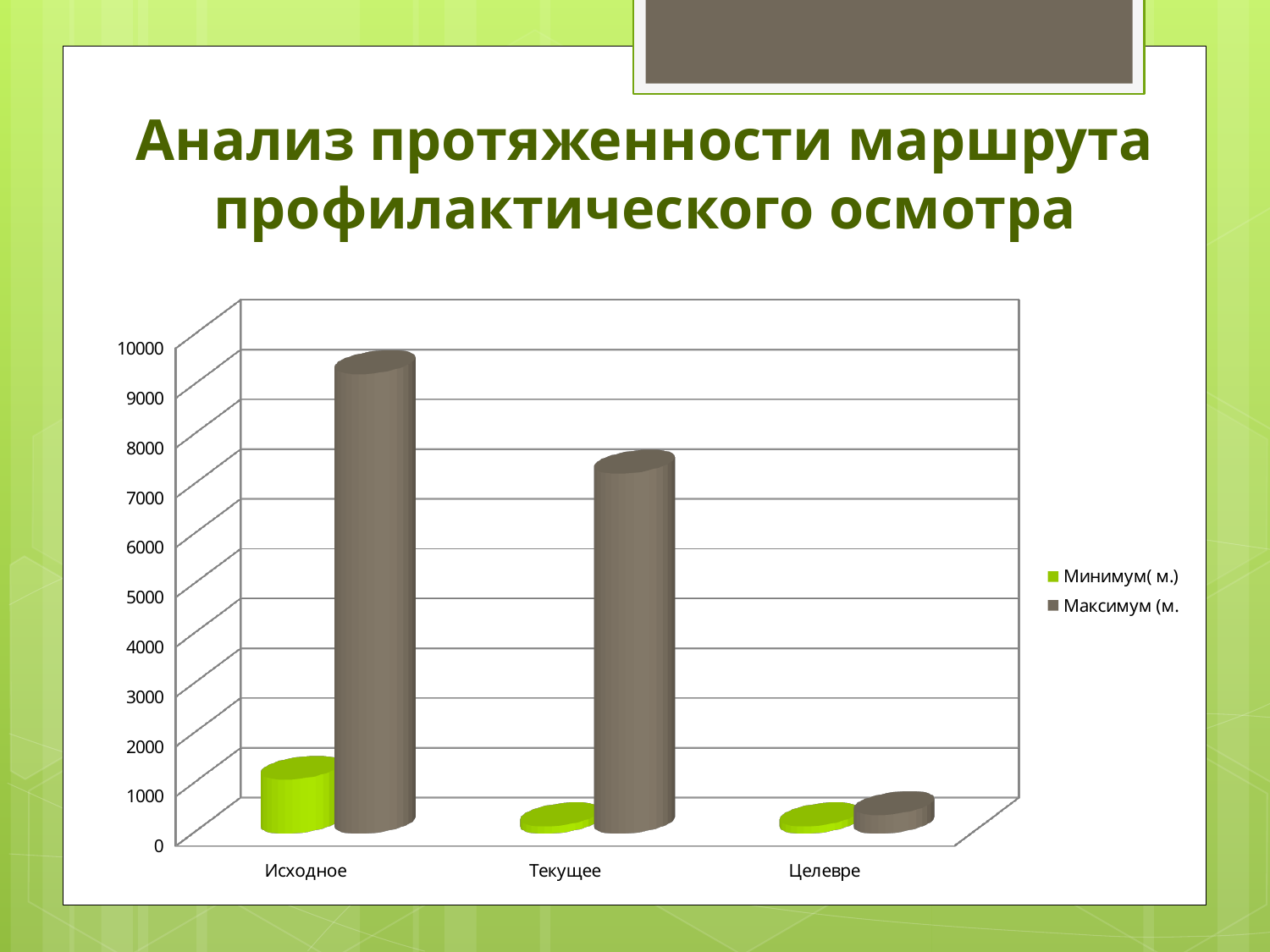
What kind of chart is shown on the slide? bar chart Which category has the highest value for the Минимум( м.) series? Исходное How many series does the chart's legend list? 2 How many categories are shown on the x axis of the chart? 3 Which category has the highest value for the Максимум (м.) series? Исходное Which is larger: the Максимум (м.) value for Исходное or for Текущее? Исходное Is the Максимум (м.) value for Текущее greater or less than 8000? less Is the Максимум (м.) value for Исходное greater or less than 8000? greater Which category has the lowest value for the Максимум (м.) series? Целевре Is the Максимум (м.) value for Целевре greater or less than 1000? less What is the title of the slide containing the chart? Анализ протяженности маршрута профилактического осмотра Do the Максимум (м.) values rise or fall from Исходное to Целевре along the x axis? fall